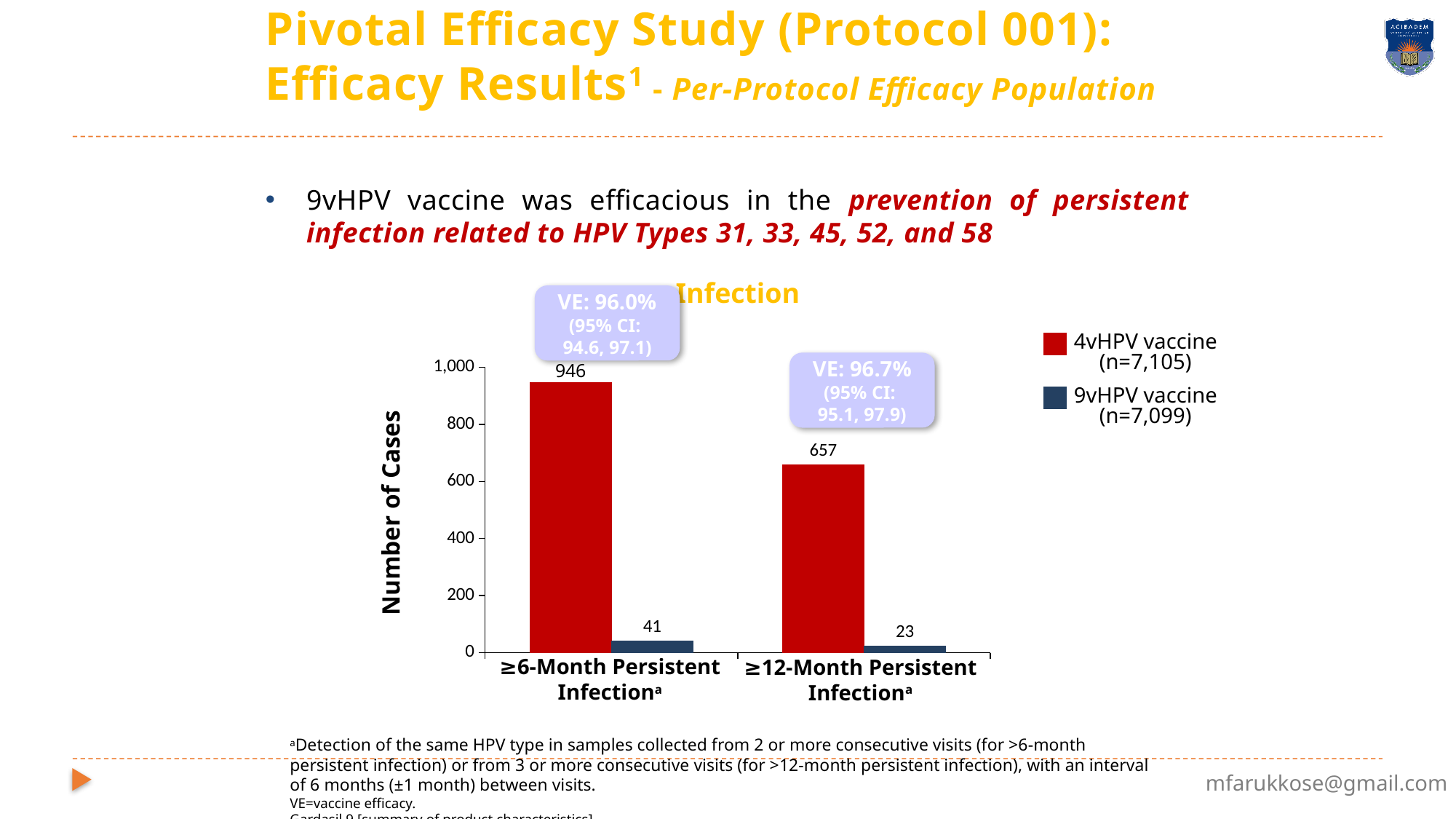
How many series does the legend list? 2 Which vaccine has more cases of ≥12-Month Persistent Infection, 4vHPV or 9vHPV? 4vHPV vaccine What is the label of the y axis? Number of Cases What is the difference in cases between the 4vHPV and 9vHPV vaccines for ≥6-Month Persistent Infection? 905 What is the number of cases for the 9vHPV vaccine in the ≥12-Month Persistent Infection category? 23 Which bar shows the lowest number of cases? 9vHPV vaccine, ≥12-Month Persistent Infection What is the difference in 4vHPV vaccine cases between ≥6-Month and ≥12-Month Persistent Infection? 289 What is the number of cases for the 9vHPV vaccine in the ≥6-Month Persistent Infection category? 41 Which bar shows the highest number of cases? 4vHPV vaccine, ≥6-Month Persistent Infection What is the number of cases for the 4vHPV vaccine in the ≥6-Month Persistent Infection category? 946 What kind of chart is shown on the slide? Bar chart What is the number of cases for the 4vHPV vaccine in the ≥12-Month Persistent Infection category? 657